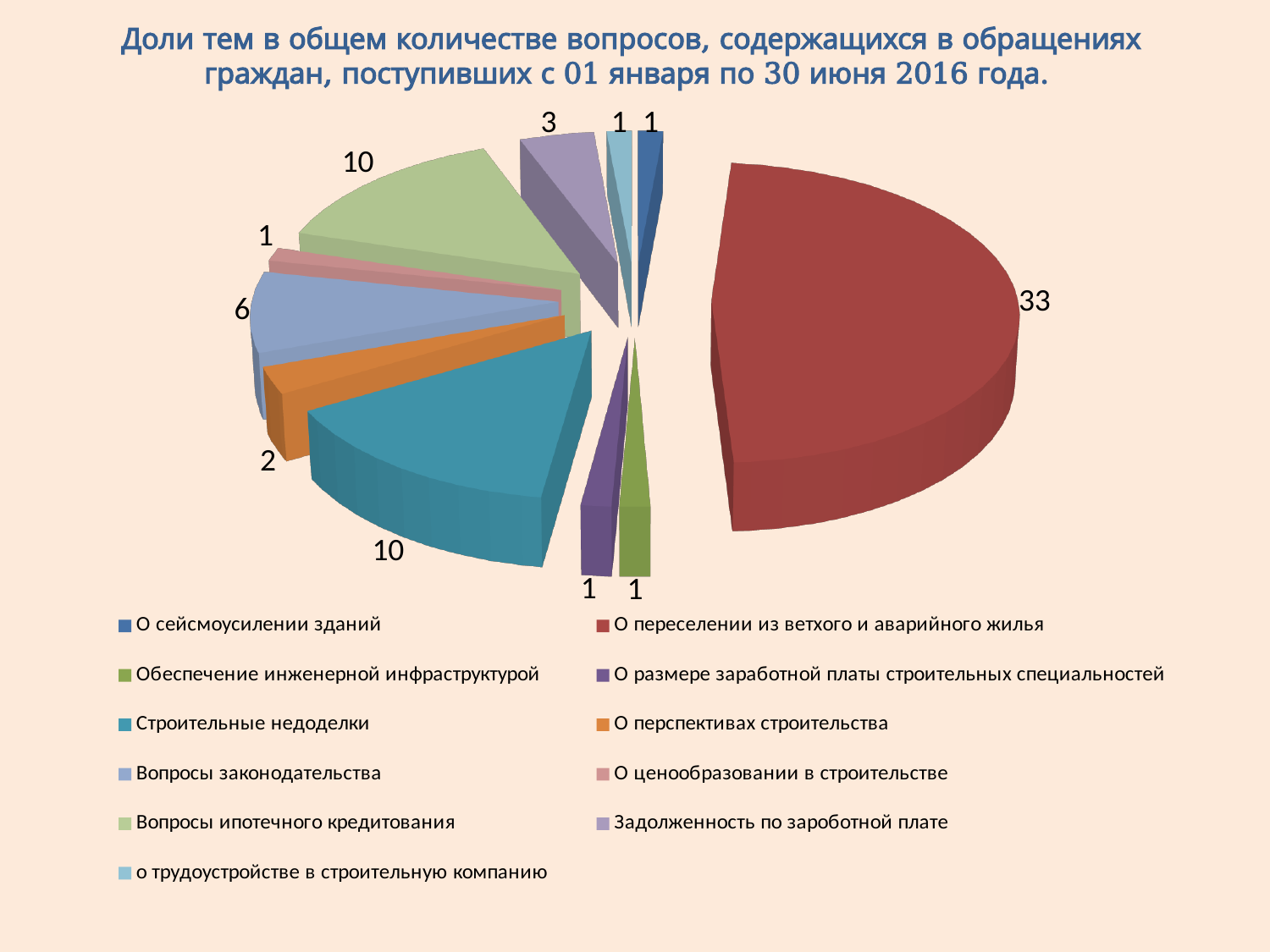
What colour is the slice for "О переселении из ветхого и аварийного жилья"? red What is the difference between the values for "О переселении из ветхого и аварийного жилья" and "Строительные недоделки"? 23 Which is larger, the value for "Вопросы законодательства" or the value for "Задолженность по заработной плате"? Вопросы законодательства What is the value for "Вопросы ипотечного кредитования"? 10 What is the value for "Задолженность по заработной плате"? 3 What is the value for "Строительные недоделки"? 10 What is the value for "О переселении из ветхого и аварийного жилья"? 33 What kind of chart is shown on the slide? pie chart What is the value for "О перспективах строительства"? 2 Which category has the largest slice of the pie? О переселении из ветхого и аварийного жилья How many categories does the legend list? 11 What is the value for "Вопросы законодательства"? 6